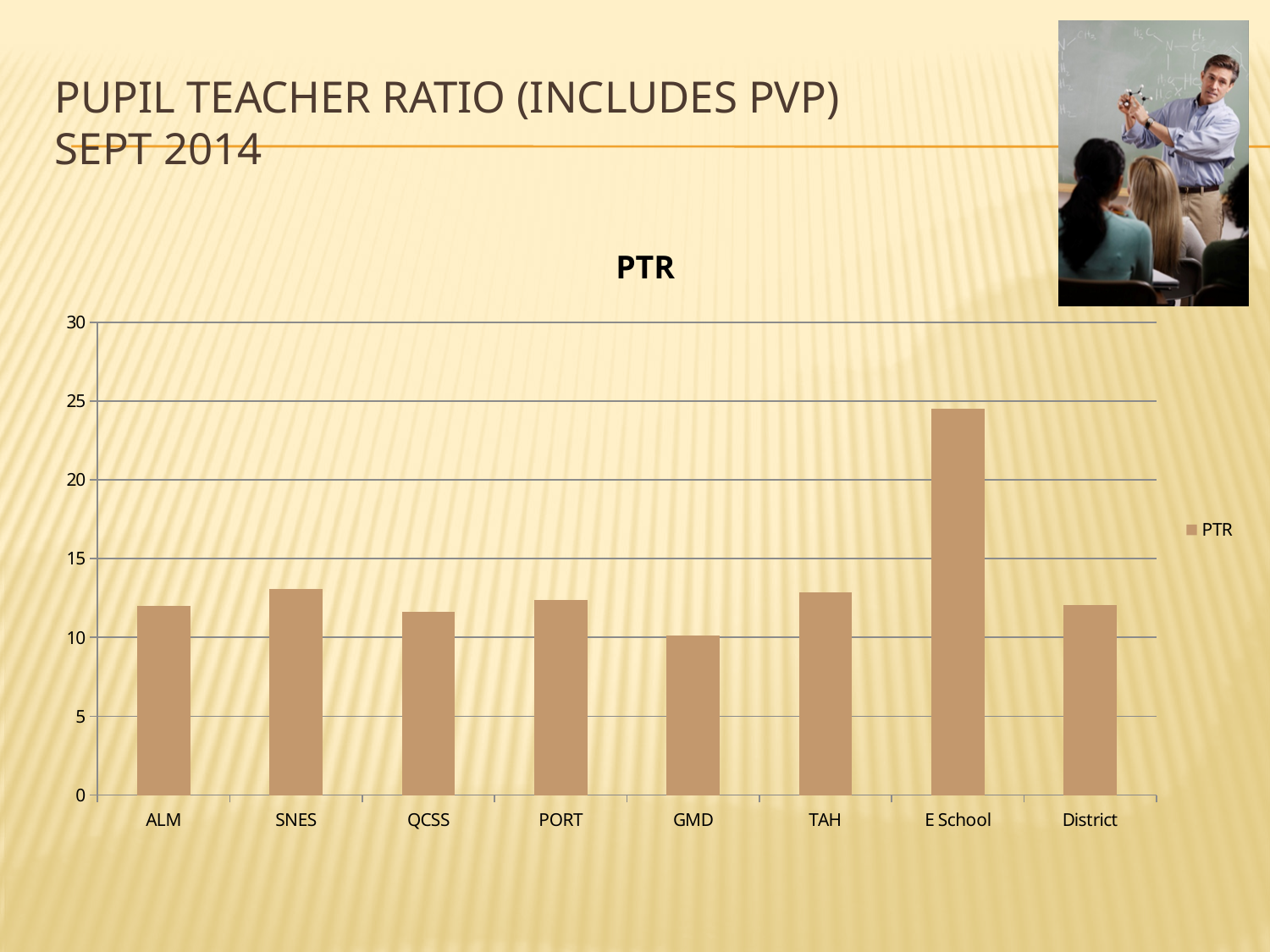
Is the PTR value for GMD greater or less than 15? less Is the PTR value for E School greater or less than 20? greater Which has a larger PTR value, SNES or GMD? SNES Which has a larger PTR value, E School or TAH? E School How many series does the legend of the PTR chart list? 1 What is the title of the chart? PTR Is the PTR value for District greater or less than 15? less How many categories are shown on the x axis of the PTR chart? 8 What kind of chart is shown on the slide? bar chart Which category has the lowest PTR value? GMD Which category has the highest PTR value? E School